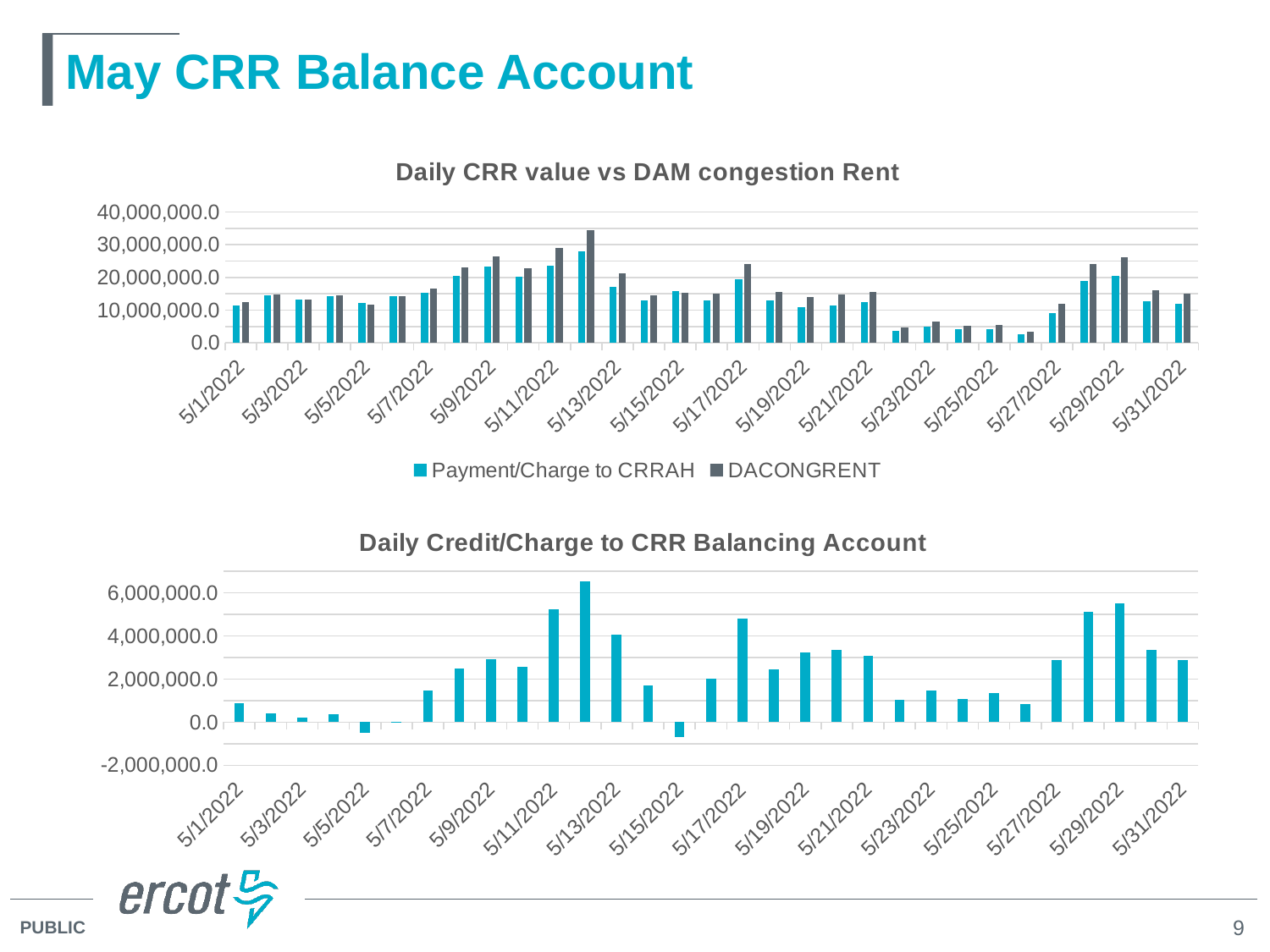
In the bottom chart "Daily Credit/Charge to CRR Balancing Account", is the value for 5/12/2022 greater or less than 6,000,000.0? greater In the top chart "Daily CRR value vs DAM congestion Rent", what are the two series named in the legend? Payment/Charge to CRRAH and DACONGRENT In the top chart "Daily CRR value vs DAM congestion Rent", on 5/12/2022 which series has the larger value, Payment/Charge to CRRAH or DACONGRENT? DACONGRENT What kind of chart is the top chart titled "Daily CRR value vs DAM congestion Rent"? bar chart In the bottom chart "Daily Credit/Charge to CRR Balancing Account", on which date is the value highest? 5/12/2022 In the bottom chart "Daily Credit/Charge to CRR Balancing Account", on which date is the value lowest? 5/15/2022 How many series does the legend of the top chart "Daily CRR value vs DAM congestion Rent" list? 2 In the top chart "Daily CRR value vs DAM congestion Rent", is the DACONGRENT value for 5/12/2022 greater or less than 30,000,000.0? greater In the top chart "Daily CRR value vs DAM congestion Rent", on which date is the DACONGRENT value highest? 5/12/2022 How many dates are shown on the x axis of the bottom chart "Daily Credit/Charge to CRR Balancing Account"? 16 In the bottom chart "Daily Credit/Charge to CRR Balancing Account", which date has the larger value, 5/11/2022 or 5/12/2022? 5/12/2022 In the top chart "Daily CRR value vs DAM congestion Rent", is the Payment/Charge to CRRAH value for 5/1/2022 greater or less than 20,000,000.0? less